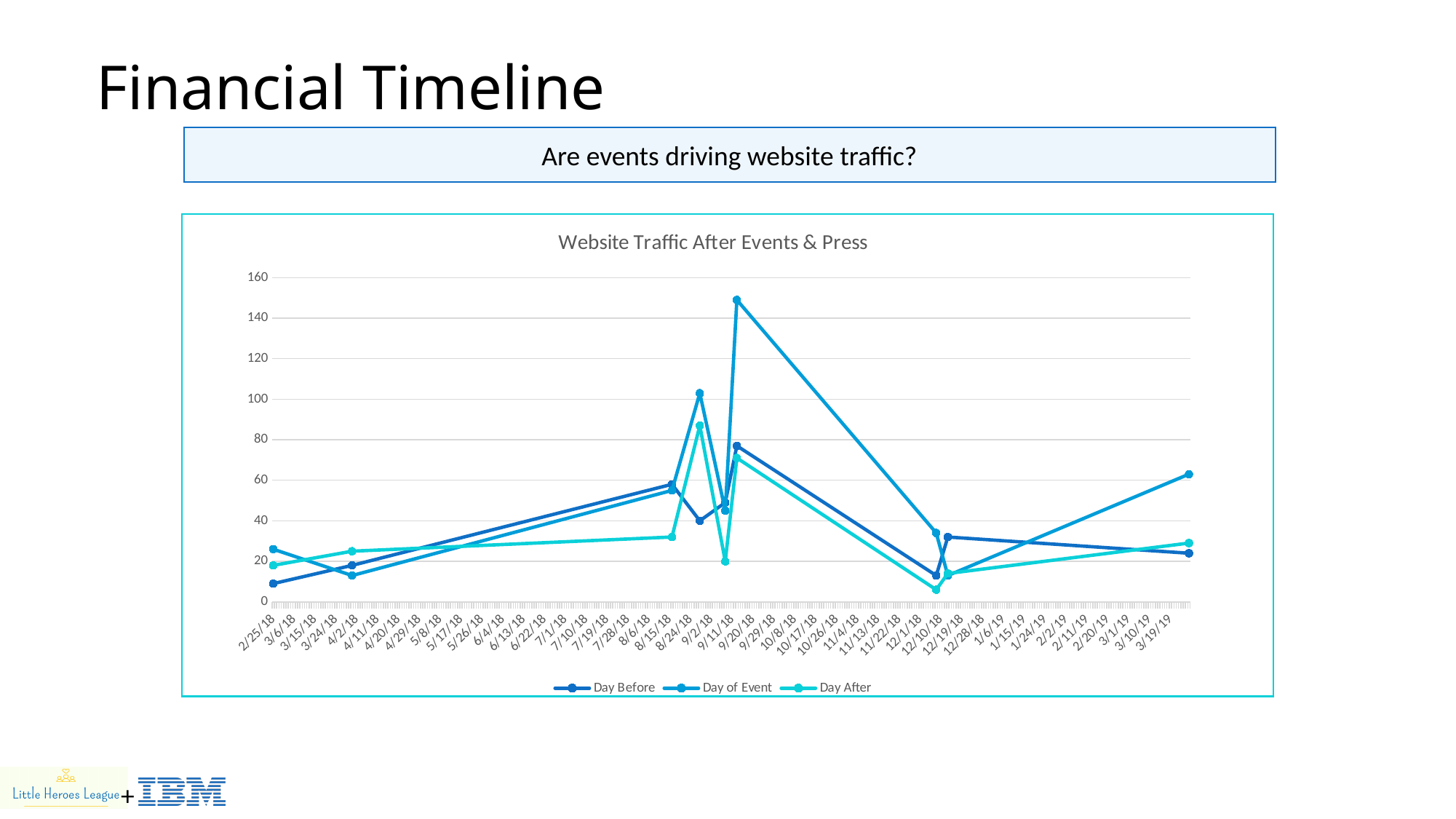
What is the title of the chart? Website Traffic After Events & Press At 8/24/18, which is larger: the Day of Event value or the Day After value? Day of Event Is the Day After value at 8/24/18 greater or less than 80? greater Which series are listed in the chart legend? Day Before, Day of Event, Day After Does the Day of Event series rise or fall between 12/1/18 and 3/19/19? Rise Is the Day After value at 12/1/18 greater or less than 20? less Which series reaches the highest value on the chart? Day of Event What type of chart is shown on the slide? Line chart How many series does the chart legend list? 3 Is the peak value of the Day of Event series greater or less than 140? greater At 9/20/18, which is larger: the Day of Event value or the Day Before value? Day of Event